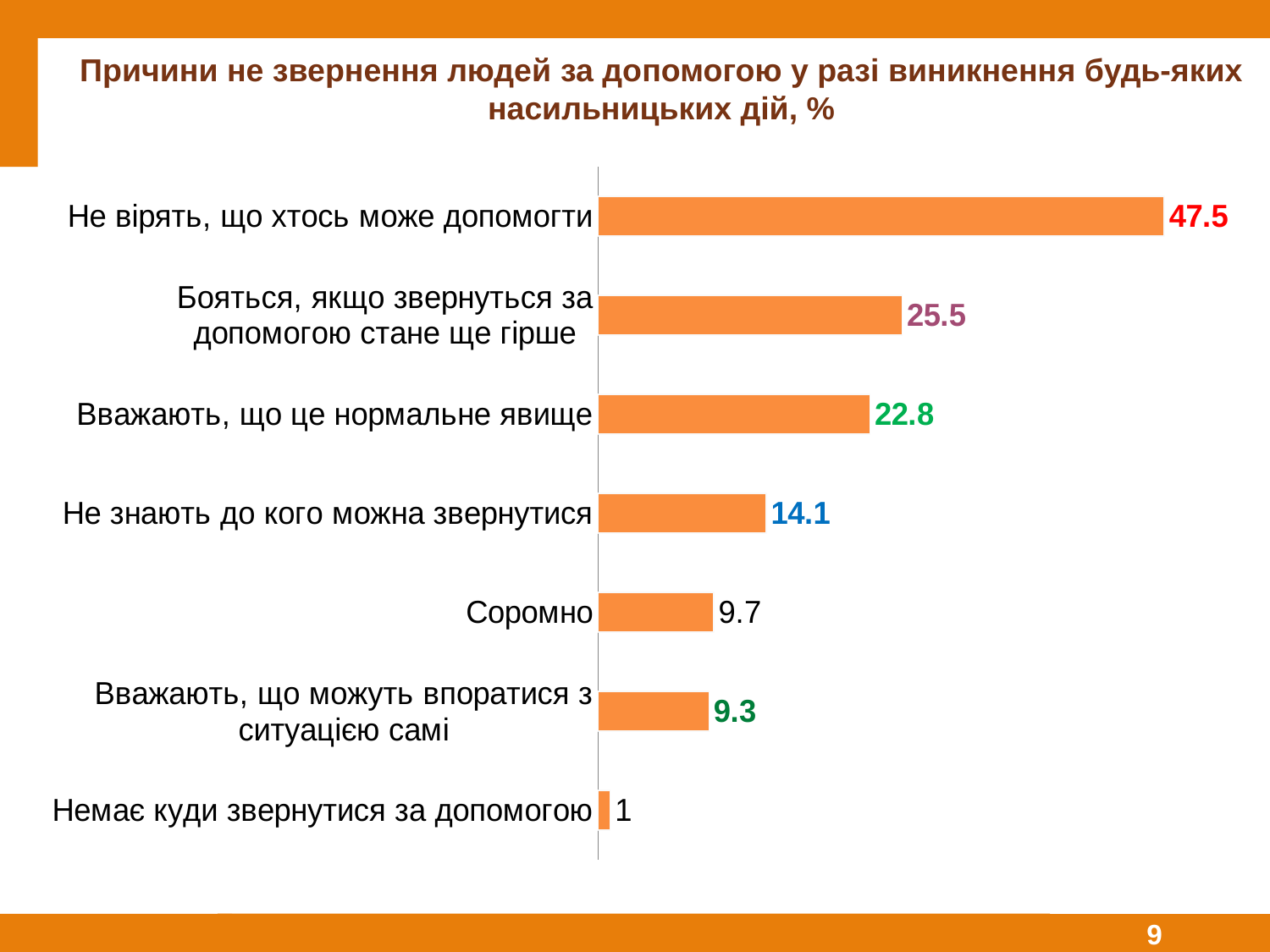
What is the value for "Не вірять, що хтось може допомогти"? 47.5 How many categories are shown in the chart? 7 What is the difference between the values for "Не вірять, що хтось може допомогти" and "Бояться, якщо звернуться за допомогою стане ще гірше"? 22 What is the title of the chart? Причини не звернення людей за допомогою у разі виникнення будь-яких насильницьких дій, % What is the value for "Не знають до кого можна звернутися"? 14.1 What is the value for "Вважають, що можуть впоратися з ситуацією самі"? 9.3 Which category has the lowest value? Немає куди звернутися за допомогою What is the value for "Соромно"? 9.7 What is the difference between the values for "Вважають, що це нормальне явище" and "Не знають до кого можна звернутися"? 8.7 Which category has the highest value? Не вірять, що хтось може допомогти Which is larger: the value for "Бояться, якщо звернуться за допомогою стане ще гірше" or for "Вважають, що це нормальне явище"? Бояться, якщо звернуться за допомогою стане ще гірше What kind of chart is shown on the slide? Bar chart